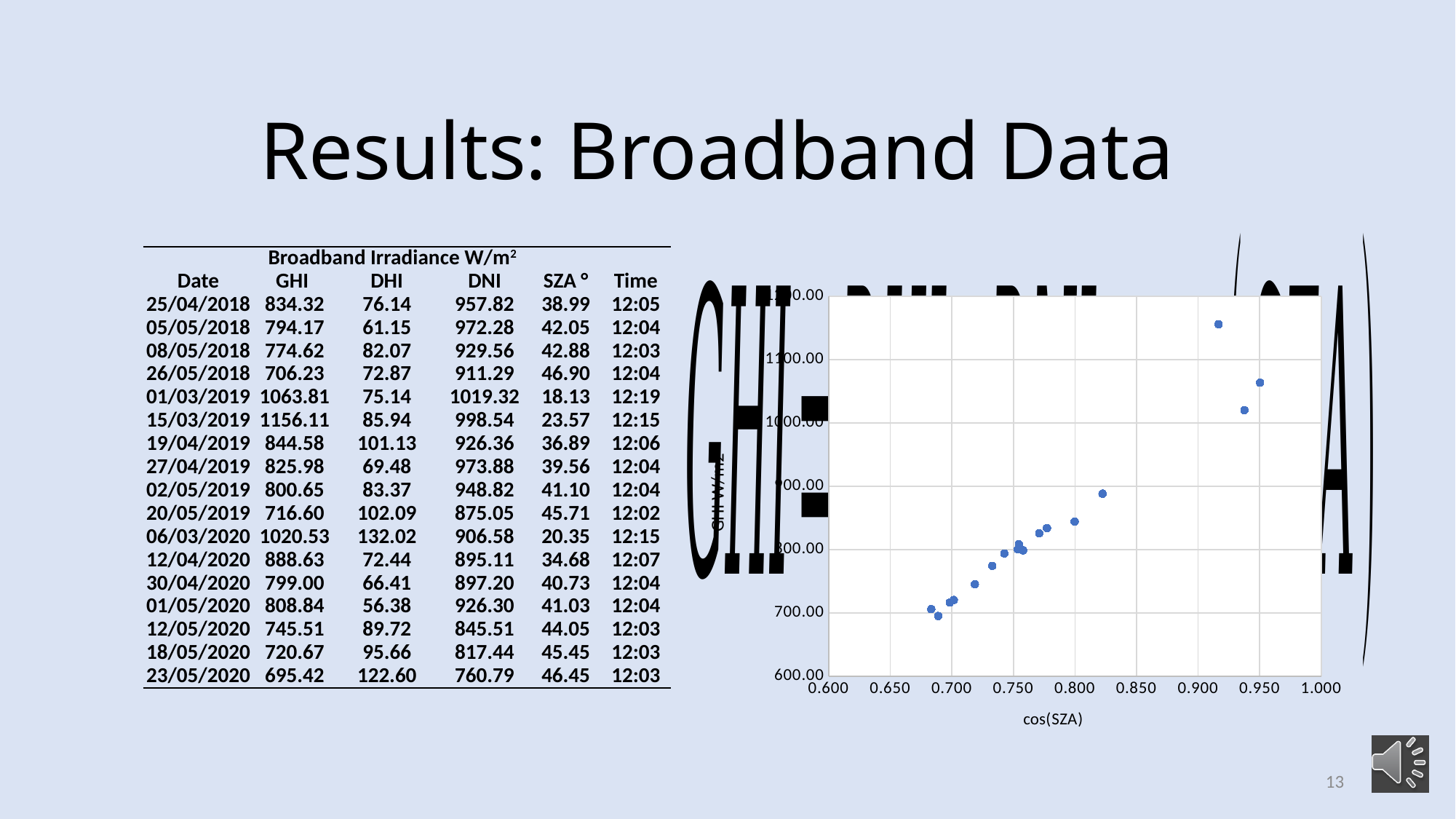
In the scatter chart, which has the larger y value: the point near cos(SZA) = 0.950 or the point near cos(SZA) = 0.820? the point near 0.950 What is the lowest value shown on the y axis of the scatter chart? 600.00 In the scatter chart, is the point near cos(SZA) = 0.800 greater or less than 900 on the y axis? less In the scatter chart, are the points near cos(SZA) = 0.700 greater or less than 800 on the y axis? less What kind of chart is shown on the right of the slide? scatter chart In the scatter chart, is the highest plotted point's cos(SZA) value greater or less than 0.900? greater In the scatter chart, do the GHI values generally rise or fall as cos(SZA) increases? rise What is the label on the x axis of the scatter chart? cos(SZA)